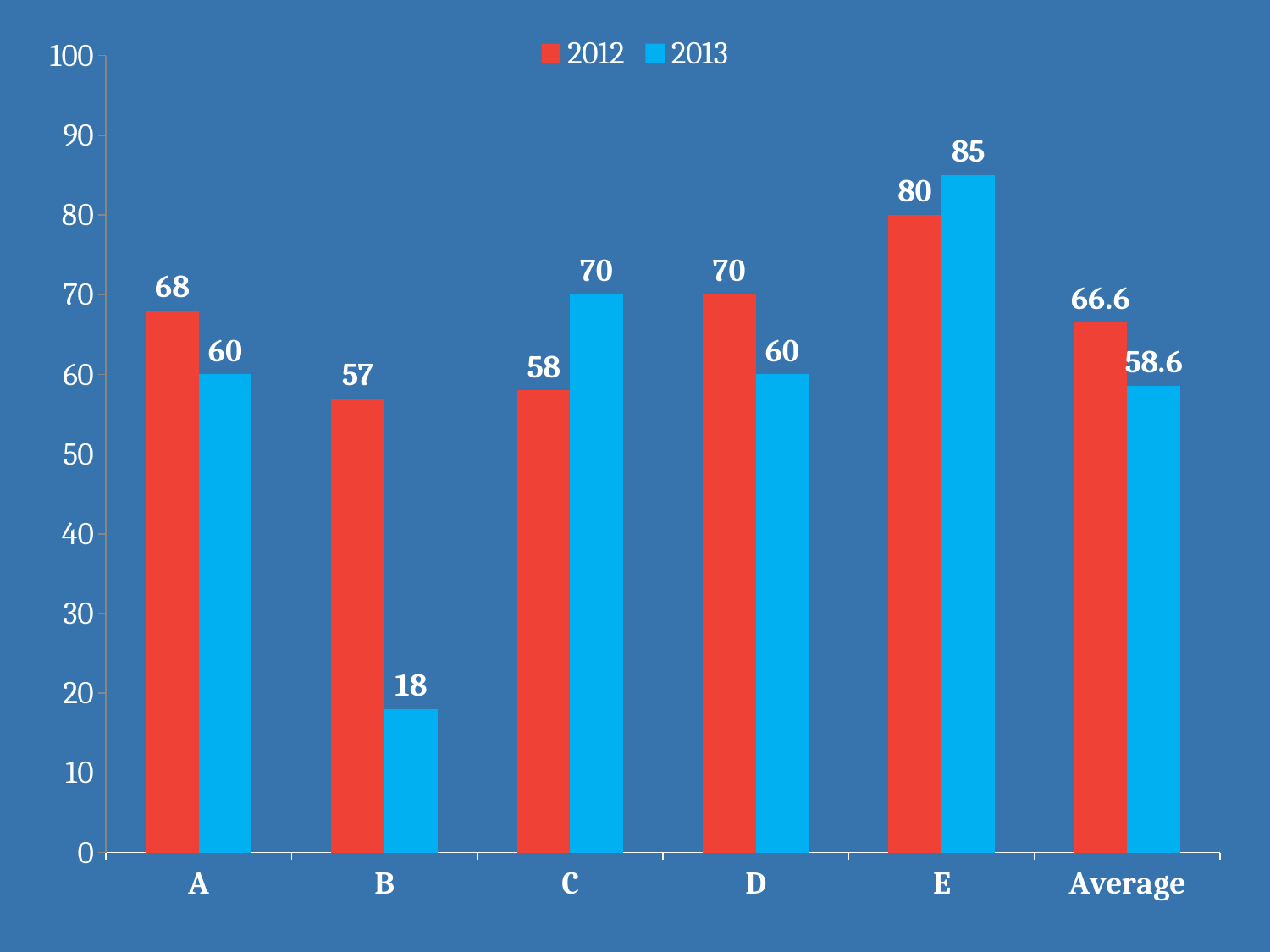
Which category has the lowest value in the 2012 series? B What is the difference between the 2012 and 2013 values for category B? 39 How many series does the legend list? 2 Which category has the highest value in the 2013 series? E How many categories are shown on the x axis? 6 Which is larger for category D, the 2012 value or the 2013 value? 2012 What is the value for category E in the 2012 series? 80 What kind of chart is shown on the slide? Bar chart What colour represents the 2013 series? Light blue What is the Average value for the 2013 series? 58.6 What is the difference between the 2013 and 2012 values for category C? 12 What is the value for category B in the 2013 series? 18